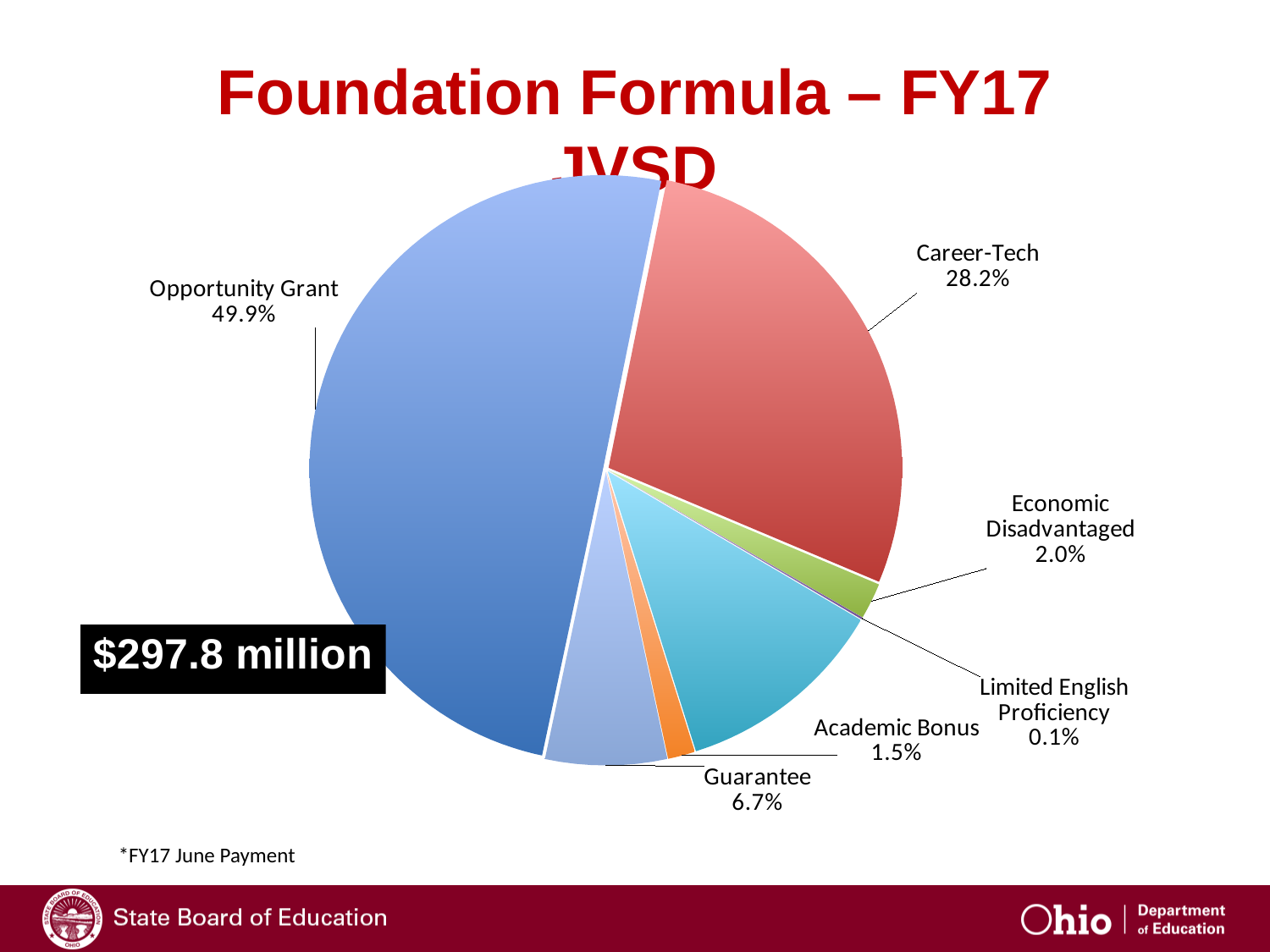
What is the value shown for Academic Bonus? 1.5% What share of the pie does Opportunity Grant represent? 49.9% What kind of chart is shown on the slide? Pie chart What is the value shown for Economic Disadvantaged? 2.0% Which labeled category has the smallest share of the pie? Limited English Proficiency What total amount is shown in the black box on the chart? $297.8 million Which labeled category has the largest share of the pie? Opportunity Grant What share of the pie does Career-Tech represent? 28.2% What is the difference in percentage points between Opportunity Grant and Career-Tech? 21.7 What is the value shown for Limited English Proficiency? 0.1% What is the value shown for Guarantee? 6.7% Which is larger, the share for Guarantee or the share for Economic Disadvantaged? Guarantee